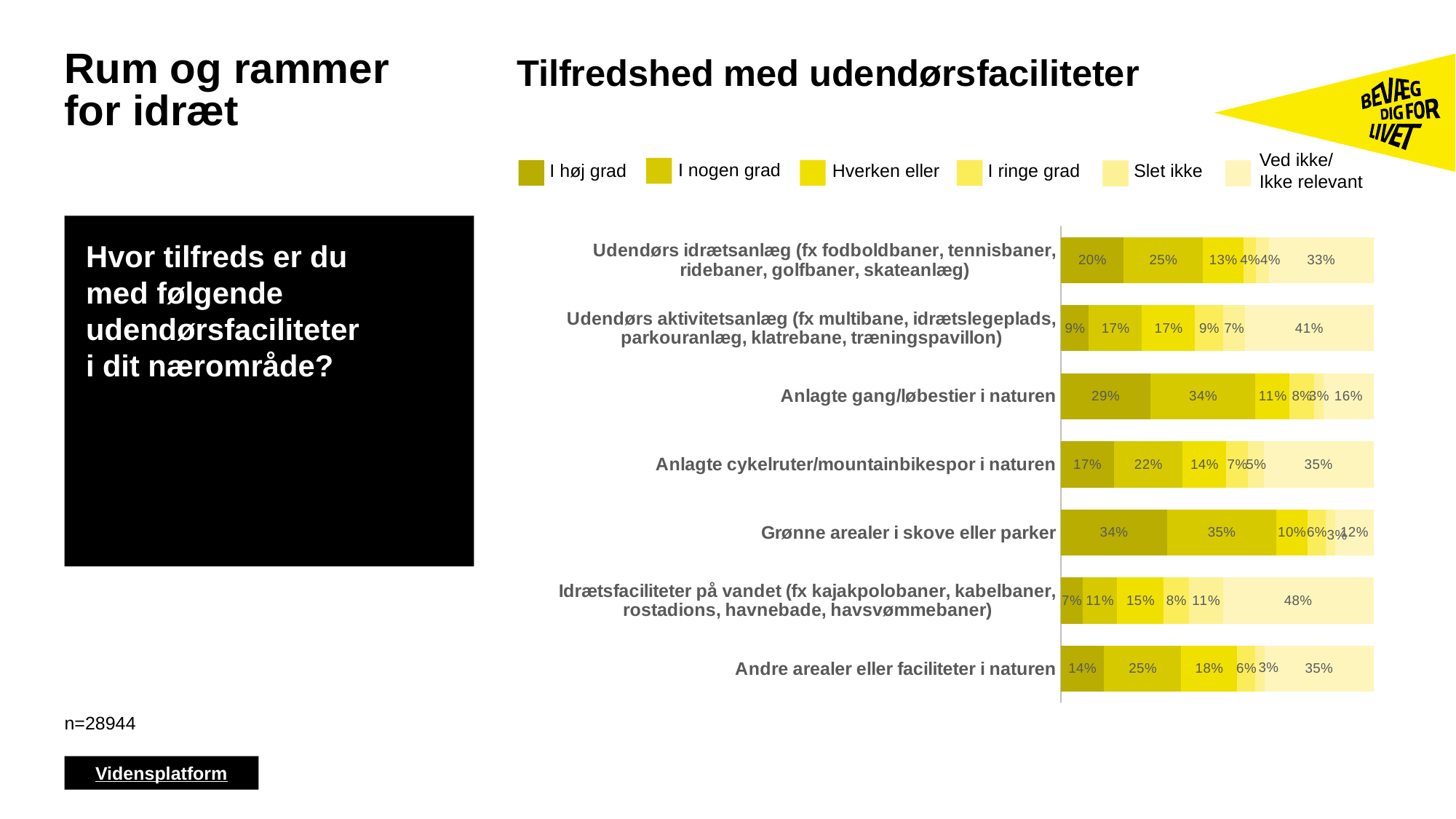
What is the difference between the 'I høj grad' values for 'Udendørs idrætsanlæg' and 'Udendørs aktivitetsanlæg'? 11% What kind of chart is shown on the slide? Stacked bar chart Which is larger: the 'Slet ikke' value for 'Idrætsfaciliteter på vandet' or for 'Anlagte cykelruter/mountainbikespor i naturen'? Idrætsfaciliteter på vandet Which category has the lowest 'Ved ikke/Ikke relevant' value? Grønne arealer i skove eller parker How many series does the legend list? 6 What is the 'Ved ikke/Ikke relevant' value for 'Idrætsfaciliteter på vandet'? 48% What is the 'I høj grad' value for 'Anlagte gang/løbestier i naturen'? 29% What is the title of the chart? Tilfredshed med udendørsfaciliteter Which category has the highest 'I høj grad' value? Grønne arealer i skove eller parker What is the 'I nogen grad' value for 'Andre arealer eller faciliteter i naturen'? 25% What is the 'Hverken eller' value for 'Udendørs aktivitetsanlæg'? 17% How many categories (facility types) are shown in the chart? 7